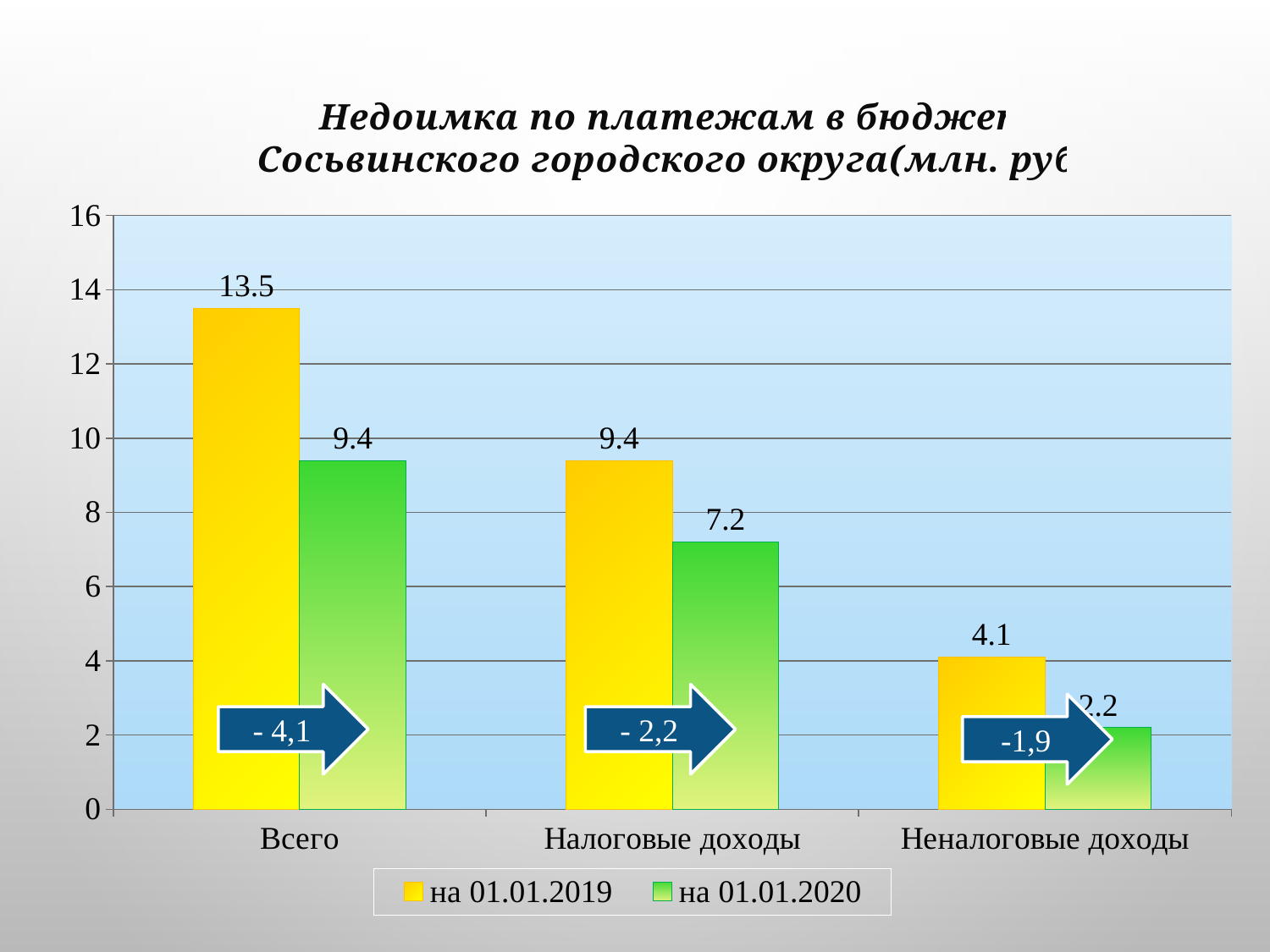
What is the value for Налоговые доходы for the series на 01.01.2020? 7.2 What is the value for Неналоговые доходы for the series на 01.01.2019? 4.1 What kind of chart is shown on the slide? Bar chart Is the value for Неналоговые доходы for the series на 01.01.2019 greater or less than 6? less Which category has the lowest value for the series на 01.01.2020? Неналоговые доходы Which is larger: the на 01.01.2019 value for Налоговые доходы or the на 01.01.2020 value for Всего? They are equal (9.4) How many series does the legend list? 2 What is the difference between the на 01.01.2019 and на 01.01.2020 values for Налоговые доходы? 2.2 How many categories are shown on the x axis? 3 What is the value for Всего for the series на 01.01.2019? 13.5 What is the value for Всего for the series на 01.01.2020? 9.4 Which category has the highest value for the series на 01.01.2019? Всего